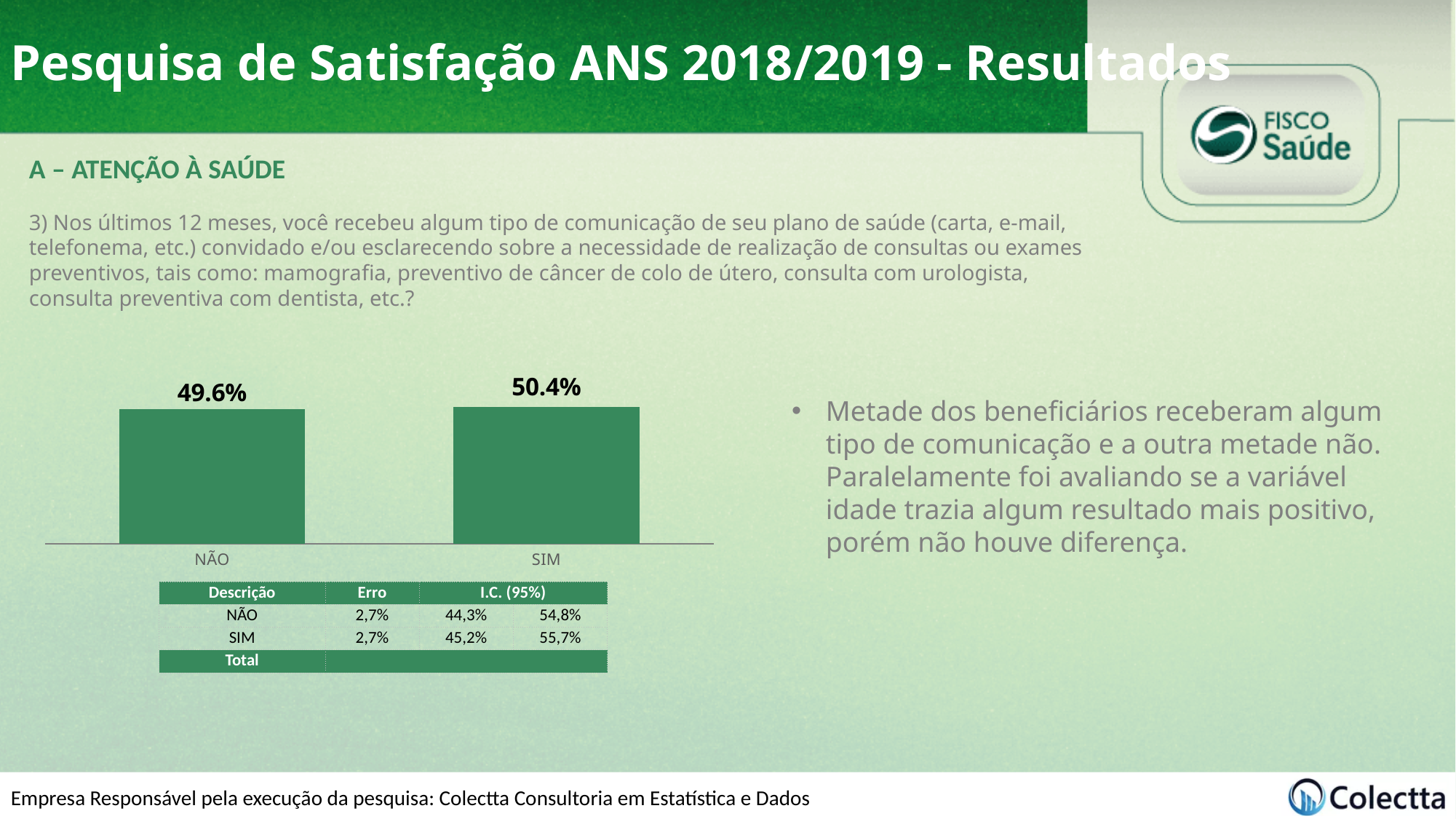
What is the difference between the SIM and NÃO values in the bar chart? 0.8% What are the category labels on the x axis of the bar chart? NÃO and SIM How many categories are shown in the bar chart? 2 Which category has the lower value in the bar chart? NÃO What colour are the bars in the chart? green What kind of chart is shown on the slide? bar chart Which category has the higher value in the bar chart? SIM Is the value for SIM larger or smaller than the value for NÃO? larger What is the value for NÃO in the bar chart? 49.6% What is the value for SIM in the bar chart? 50.4%